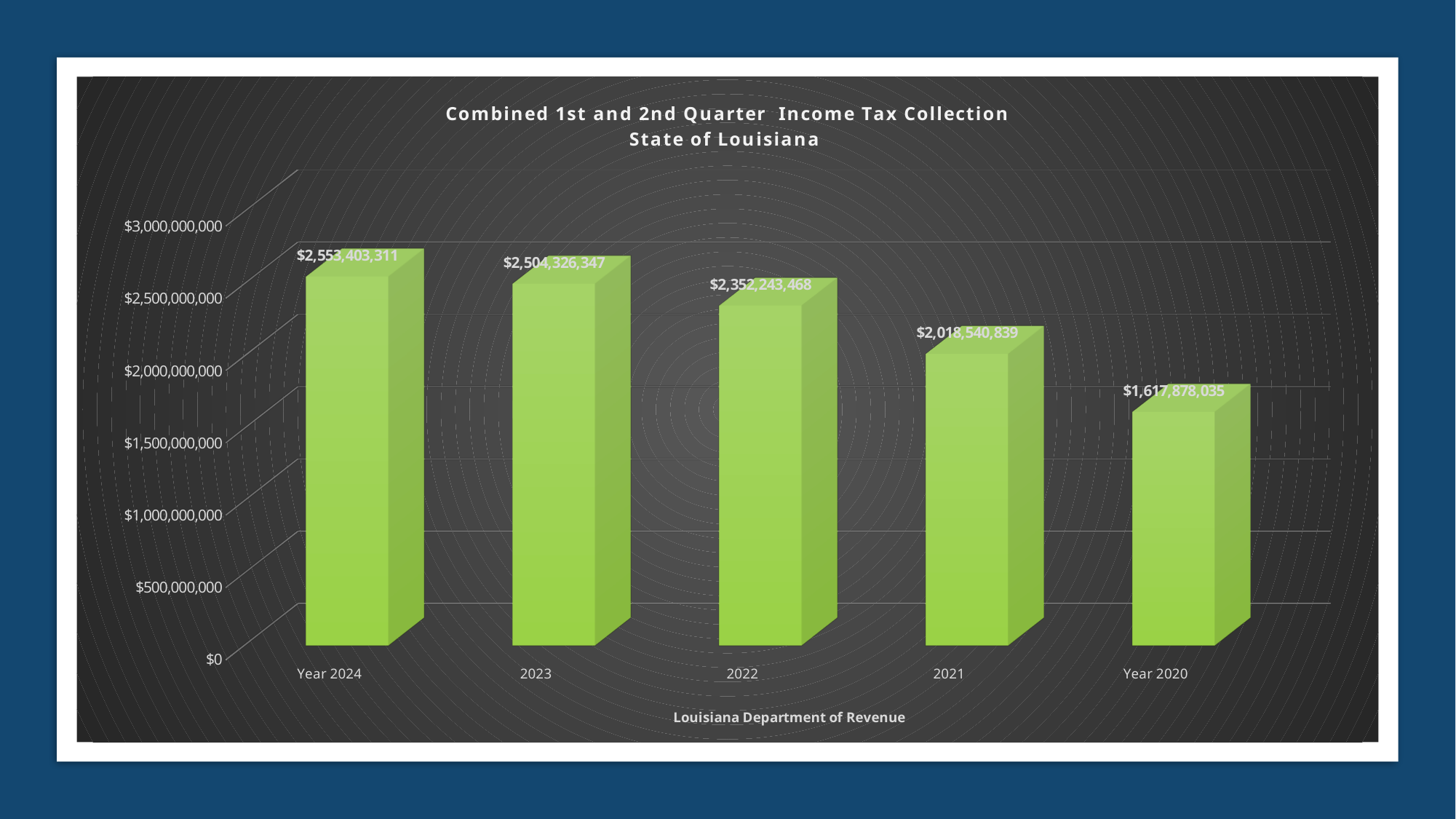
Do the values rise or fall moving from left to right along the x axis? fall Is the value for 2021 greater or less than $2,500,000,000? less Which is larger, the value for 2022 or the value for 2021? 2022 What is the value for 2022? $2,352,243,468 Which year has the lowest income tax collection? Year 2020 How many years are shown on the chart? 5 What is the value for Year 2020? $1,617,878,035 What is the difference between the values for Year 2024 and 2023? $49,076,964 What kind of chart is this? bar chart What is the value for Year 2024? $2,553,403,311 What is the difference between the values for 2021 and Year 2020? $400,662,804 Which year has the highest income tax collection? Year 2024